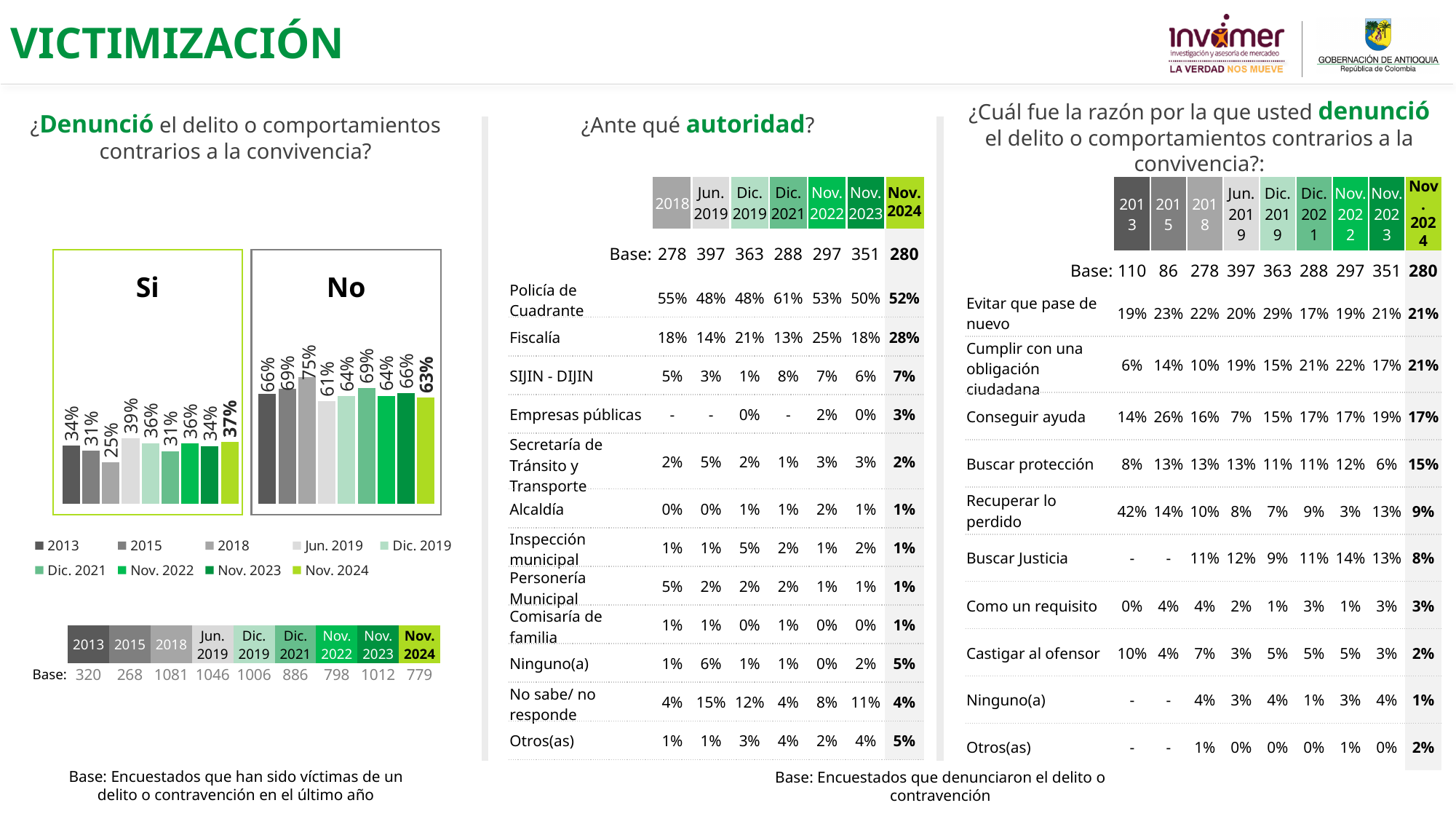
In the "¿Denunció el delito...?" chart, which year has the lowest "Si" value? 2018 In the "¿Denunció el delito...?" chart, which year has the highest "No" value? 2018 In the "¿Denunció el delito...?" chart, what is the difference between the "No" and "Si" values for Nov. 2024? 26 percentage points In the "¿Denunció el delito...?" chart, what is the value for "Si" in Nov. 2024? 37% In the "¿Denunció el delito...?" chart, what is the value for "Si" in Jun. 2019? 39% In the "¿Denunció el delito...?" chart, what is the difference between the "Si" values for Jun. 2019 and 2018? 14 percentage points In the "¿Denunció el delito...?" chart, what is the value for "No" in Dic. 2021? 69% How many series does the legend of the "¿Denunció el delito...?" chart list? 9 What type of chart is shown under the question "¿Denunció el delito o comportamientos contrarios a la convivencia?"? Bar chart In the "¿Denunció el delito...?" chart, what is the value for "No" in 2018? 75% How many response categories (groups of bars) does the "¿Denunció el delito...?" chart show? 2 In the "¿Denunció el delito...?" chart, which is larger: the "Si" value for Jun. 2019 or the "Si" value for Nov. 2023? Jun. 2019